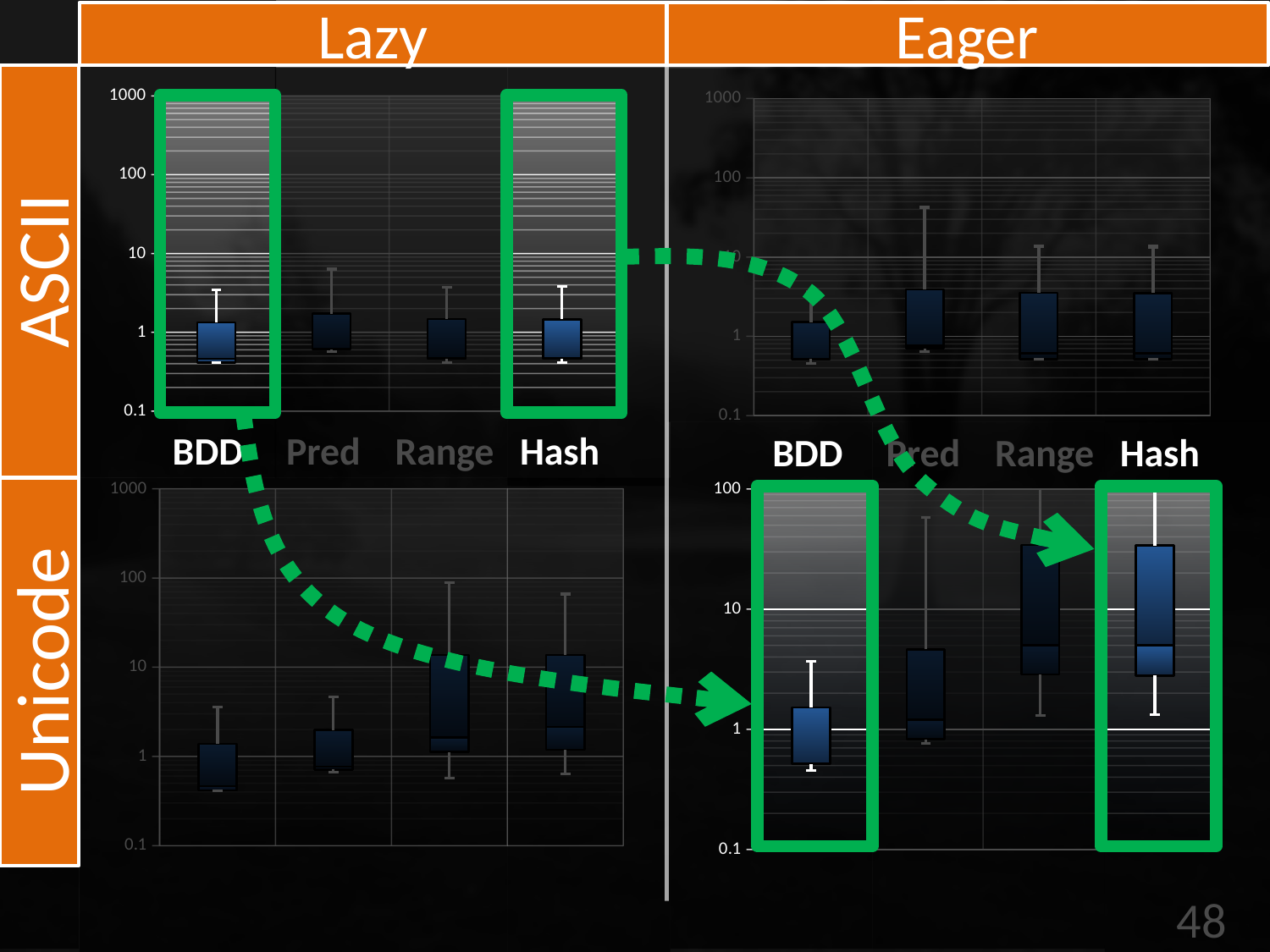
In the Eager / Unicode chart (bottom right), is the top of the box for Range greater or less than 10? greater In the Eager / Unicode chart (bottom right), which has the larger median, Pred or Range? Range In the Lazy / Unicode chart (bottom left), is the upper whisker for Range greater or less than 10? greater In the Eager / Unicode chart (bottom right), is the median for Hash greater or less than 1? greater What are the four category labels on the x axis of the Eager / Unicode chart (bottom right)? BDD, Pred, Range, Hash In the Eager / Unicode chart (bottom right), which has the larger median, BDD or Hash? Hash What is the highest tick value on the y axis of the Lazy / ASCII chart (top left)? 1000 How many categories are shown along the x axis of the Lazy / ASCII chart (top left)? 4 What is the highest tick value on the y axis of the Eager / Unicode chart (bottom right)? 100 What kind of chart is used in each of the four panels on the slide? box plot